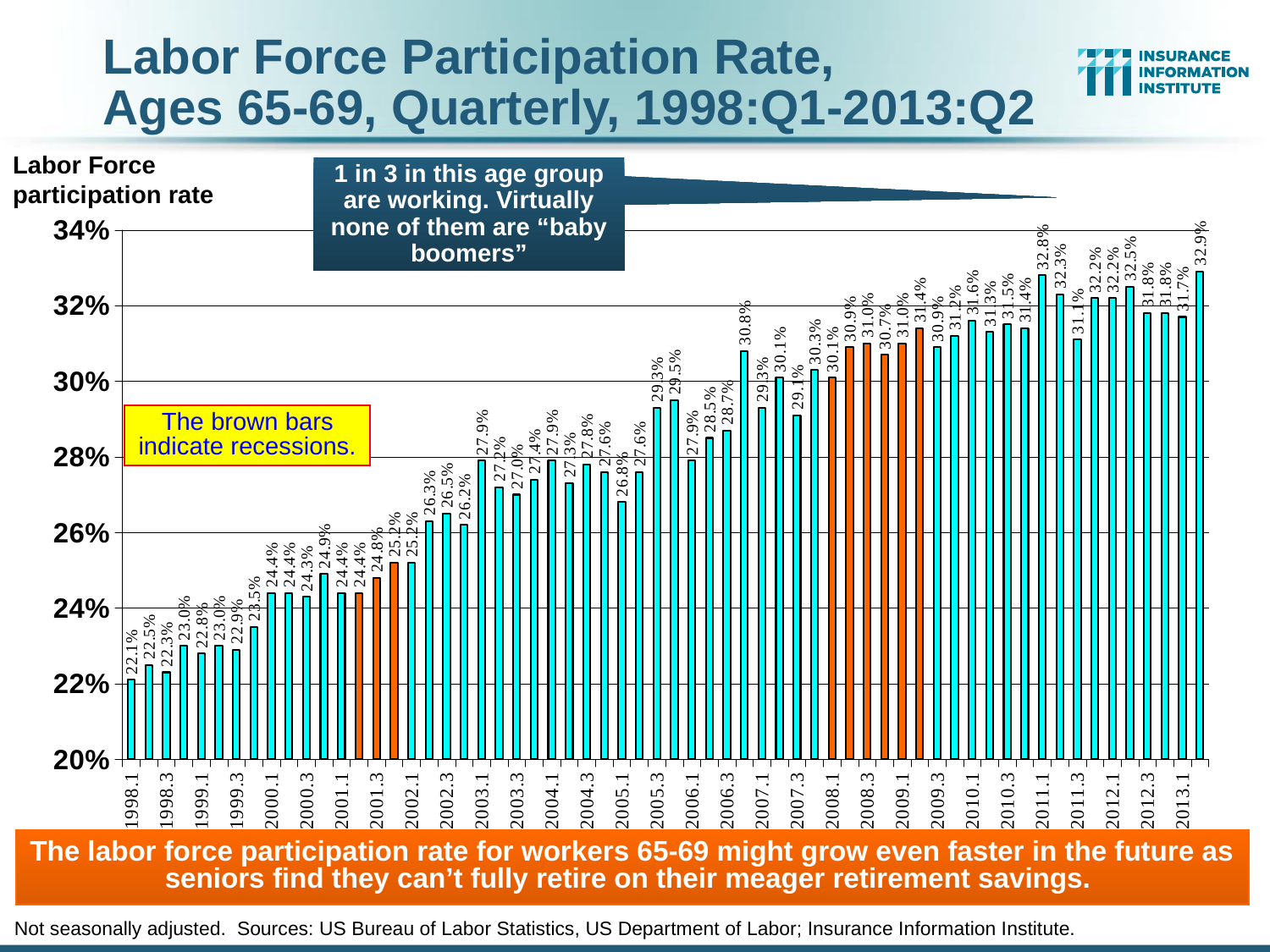
What is the labor force participation rate for 2008.1? 30.1% What is the labor force participation rate for 2005.3? 29.3% Which is larger, the rate for 2005.3 or the rate for 2003.1? 2005.3 Is the value for 2011.1 greater or less than 32%? greater What is the labor force participation rate for 1998.1? 22.1% What is the labor force participation rate for 2000.1? 24.4% What kind of chart is shown on the slide? Bar chart Do the labor force participation rates generally rise or fall from 1998 to 2013? Rise By how many percentage points does the rate for 2013.1 exceed the rate for 1998.1? 9.6 percentage points What do the brown bars in the chart indicate? Recessions What is the labor force participation rate for 2013.1? 31.7% What is the labor force participation rate for 2010.1? 31.6%